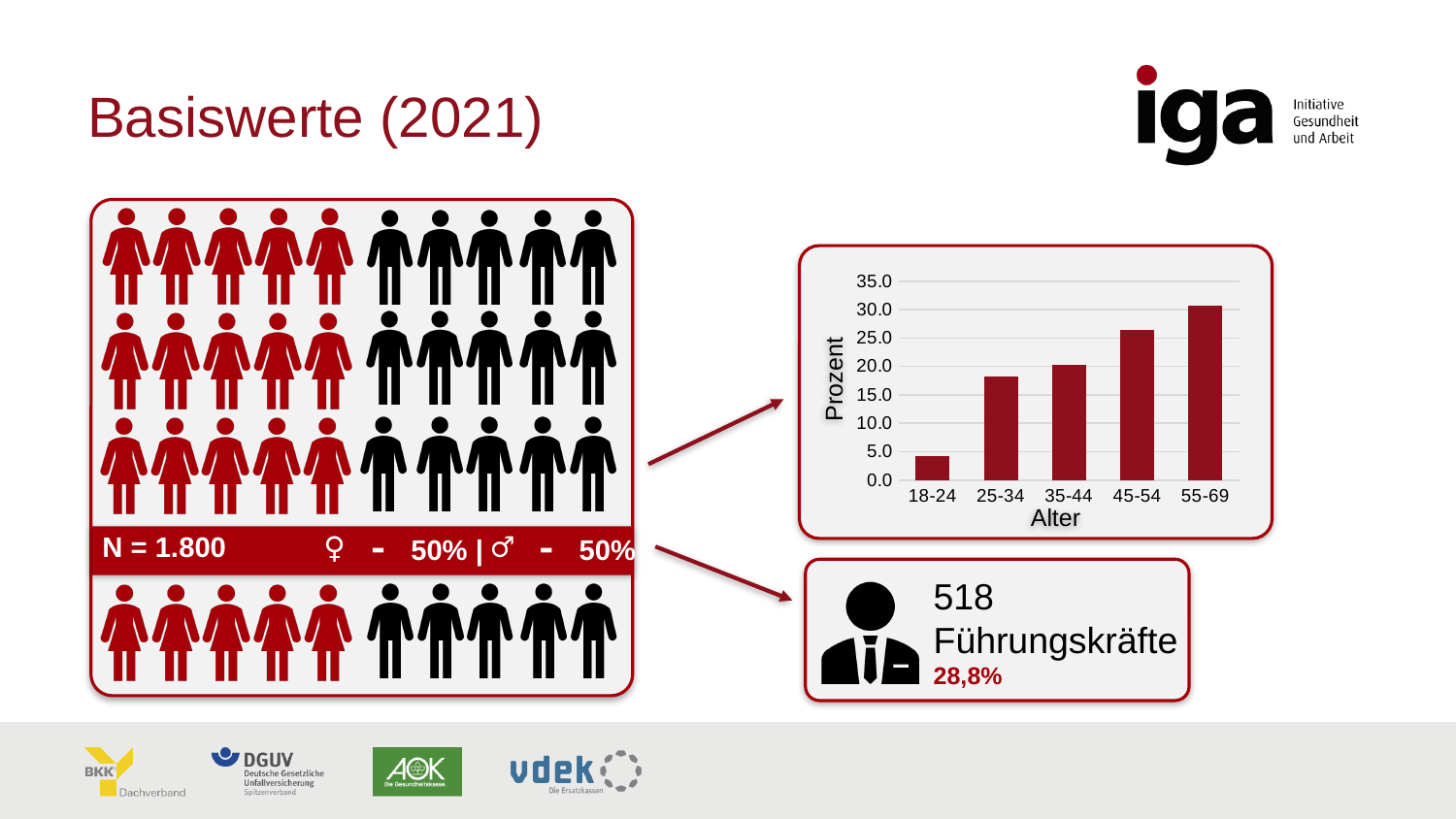
Is the value for the 25-34 age group greater or less than 20.0? less What is the label of the x axis of the bar chart? Alter What is the label of the y axis of the bar chart? Prozent Which age group has the lowest value in the bar chart? 18-24 Is the value for the 45-54 age group greater or less than 25.0? greater Which age group has the highest value in the bar chart? 55-69 Do the values in the bar chart rise or fall from the 18-24 group to the 55-69 group? rise Is the value for the 18-24 age group greater or less than 5.0? less How many age groups are shown on the x axis of the bar chart? 5 What kind of chart is shown on the slide? bar chart Which age group has the larger value, 45-54 or 35-44? 45-54